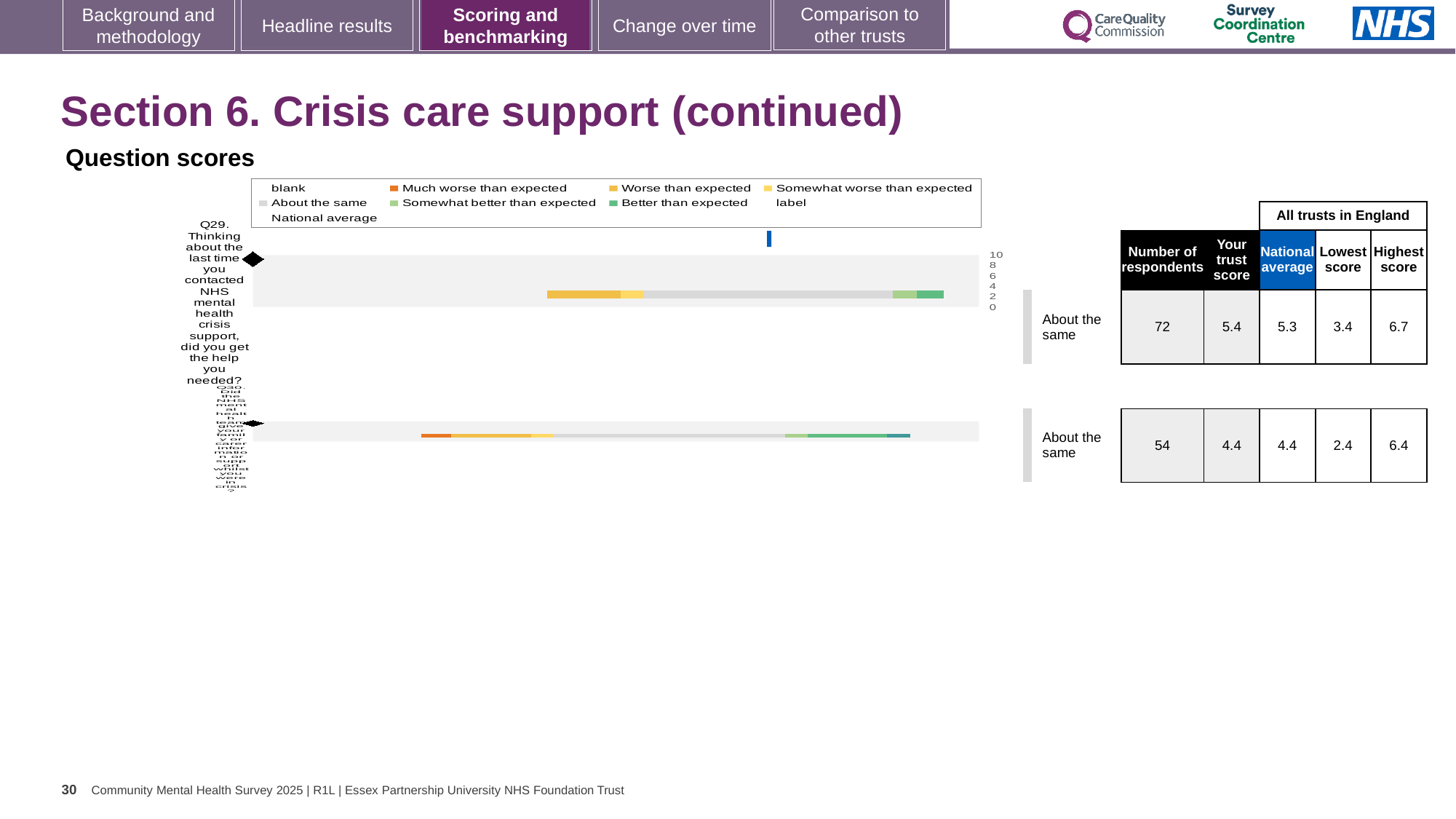
Which is larger for Q29, the trust score or the national average? trust score What is the highest score among all trusts in England for Q30? 6.4 What is the national average score for Q29? 5.3 What kind of chart is used to show the question scores on this slide? bar chart What is the lowest score among all trusts in England for Q30? 2.4 What benchmark category is shown for both Q29 and Q30 next to the chart? About the same What is the difference between the highest and lowest scores for Q29? 3.3 What is the trust score for Q29 (Thinking about the last time you contacted NHS mental health crisis support, did you get the help you needed?)? 5.4 How many entries does the legend of the question scores chart list? 9 How many more respondents answered Q29 than Q30? 18 How many questions (categories) are plotted in the question scores chart? 2 What is the number of respondents for Q29 in the table next to the chart? 72